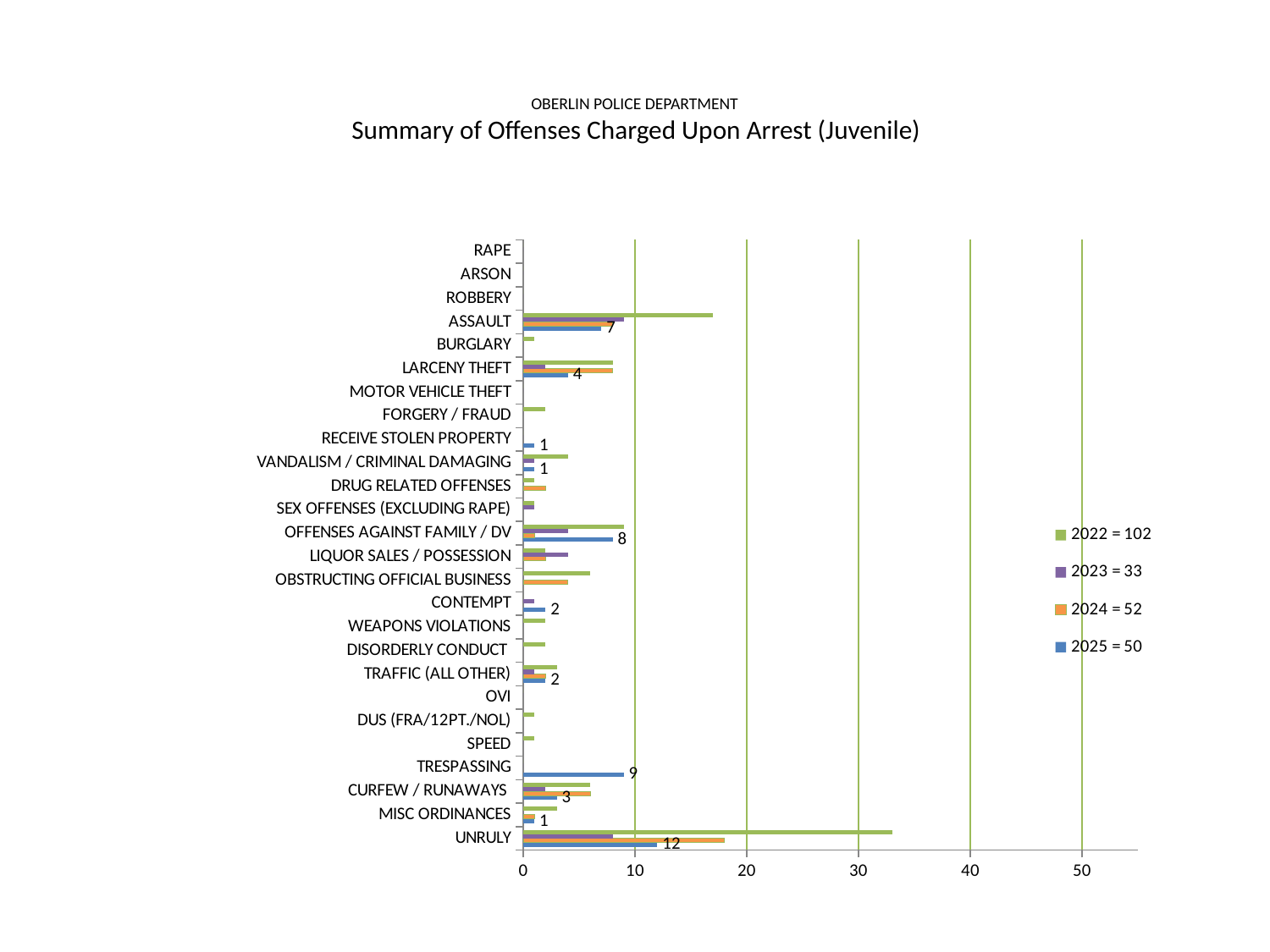
What kind of chart is shown on the slide? bar chart Is the 2022 value for UNRULY greater or less than 30? greater What is the 2025 value for UNRULY? 12 What is the 2025 value for OFFENSES AGAINST FAMILY / DV? 8 What total does the legend give for 2022? 102 How many offense categories are listed on the y axis? 26 Which offense category has the highest 2025 value? UNRULY What is the 2025 value for TRESPASSING? 9 What is the difference between the 2025 values for UNRULY and TRESPASSING? 3 What is the 2025 value for ASSAULT? 7 Which is larger for 2025: ASSAULT or LARCENY THEFT? ASSAULT How many series does the legend list? 4